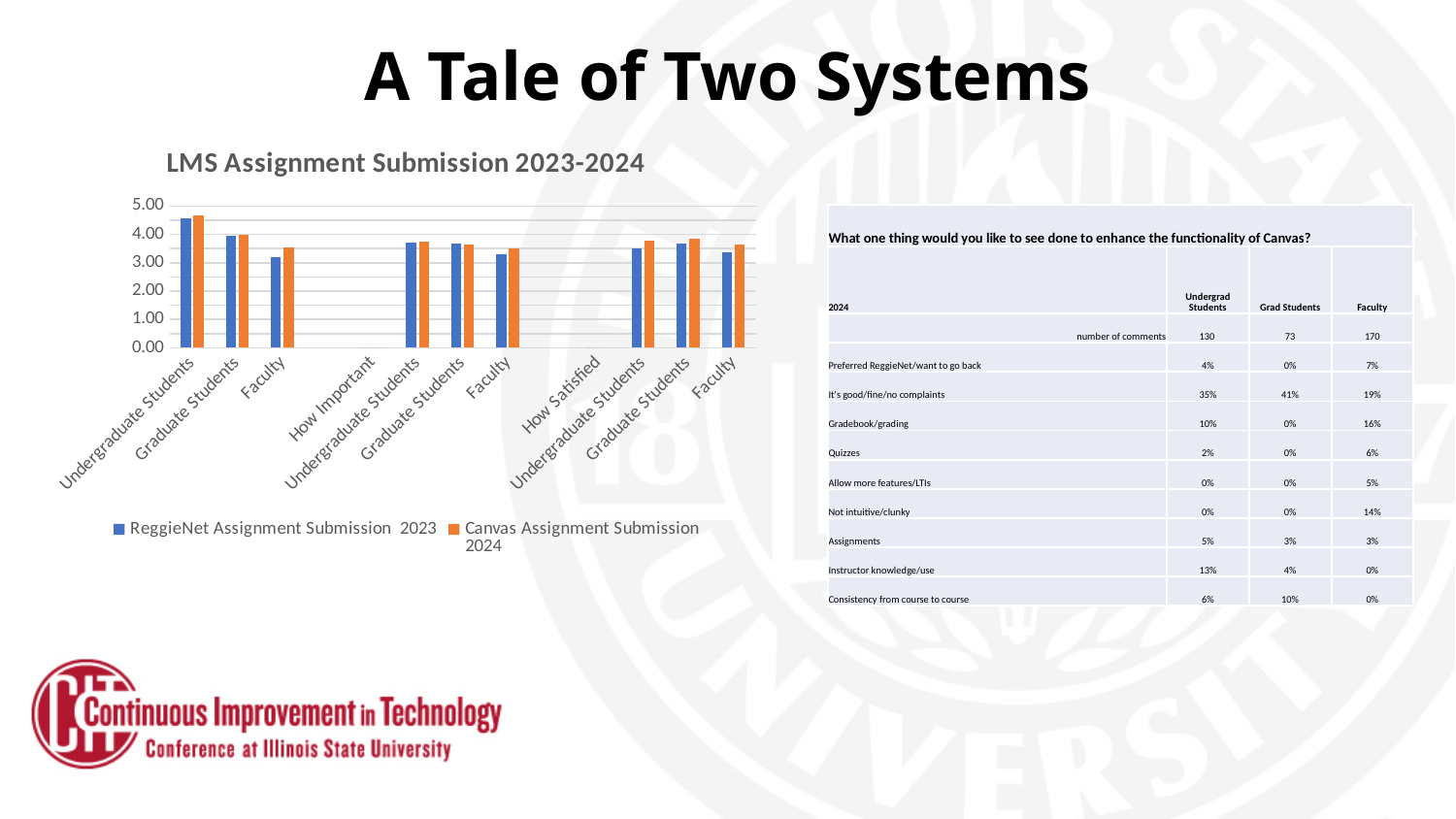
How many series does the legend of the 'LMS Assignment Submission 2023-2024' chart list? 2 In the 'LMS Assignment Submission 2023-2024' chart, which category has the highest ReggieNet Assignment Submission 2023 value? Undergraduate Students (leftmost group) What is the title of the chart on the slide? LMS Assignment Submission 2023-2024 In the 'LMS Assignment Submission 2023-2024' chart, within the leftmost group, is the ReggieNet Assignment Submission 2023 value larger for 'Undergraduate Students' or for 'Faculty'? Undergraduate Students In the 'LMS Assignment Submission 2023-2024' chart, what is the highest value shown on the vertical axis? 5.00 In the 'LMS Assignment Submission 2023-2024' chart, is the ReggieNet Assignment Submission 2023 value for the leftmost 'Faculty' category greater or less than 4.00? less How many category labels appear along the x axis of the 'LMS Assignment Submission 2023-2024' chart? 11 In the 'LMS Assignment Submission 2023-2024' chart, which colour represents the 'Canvas Assignment Submission 2024' series? orange What kind of chart is the 'LMS Assignment Submission 2023-2024' chart? bar chart In the 'LMS Assignment Submission 2023-2024' chart, is the Canvas Assignment Submission 2024 value for the leftmost 'Undergraduate Students' category greater or less than 4.00? greater In the 'LMS Assignment Submission 2023-2024' chart, is the Canvas Assignment Submission 2024 value for the rightmost 'Faculty' category greater or less than 4.00? less